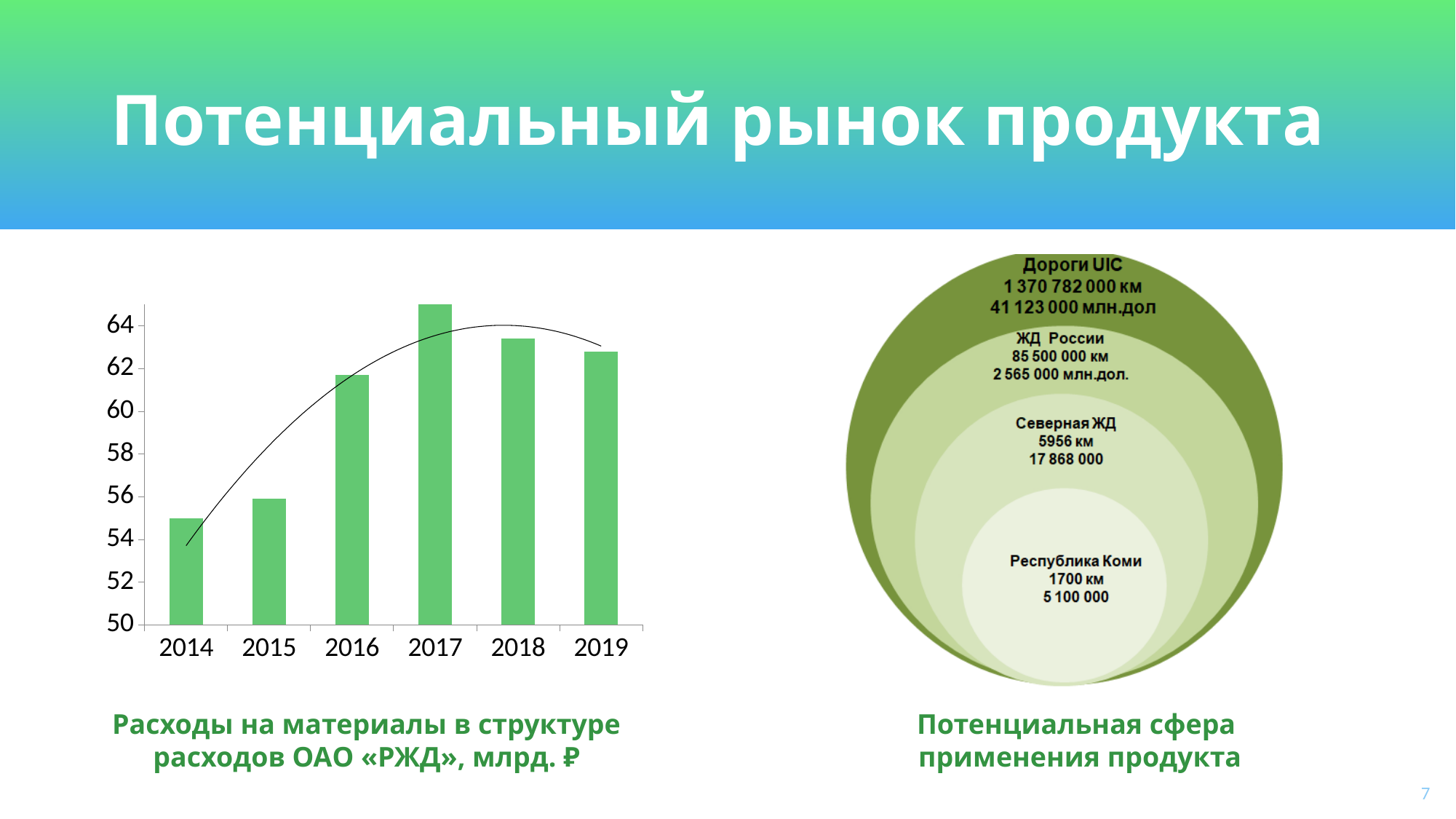
What kind of chart is shown on the left side of the slide? bar chart In the left bar chart, is the value for 2016 greater or less than 60? greater In the left bar chart, which year has the highest bar? 2017 In the left bar chart, how many years are shown on the x axis? 6 In the left bar chart, which year has the lowest bar? 2014 In the left bar chart, is the value for 2019 greater or less than 64? less In the right nested-circle diagram, what length in km is given for Республика Коми? 1700 км What is the caption under the left bar chart? Расходы на материалы в структуре расходов ОАО «РЖД», млрд. ₽ In the left bar chart, which is larger, the value for 2016 or the value for 2015? 2016 In the left bar chart, is the value for 2014 greater or less than 56? less In the left bar chart, do the values rise or fall from 2014 to 2017? rise